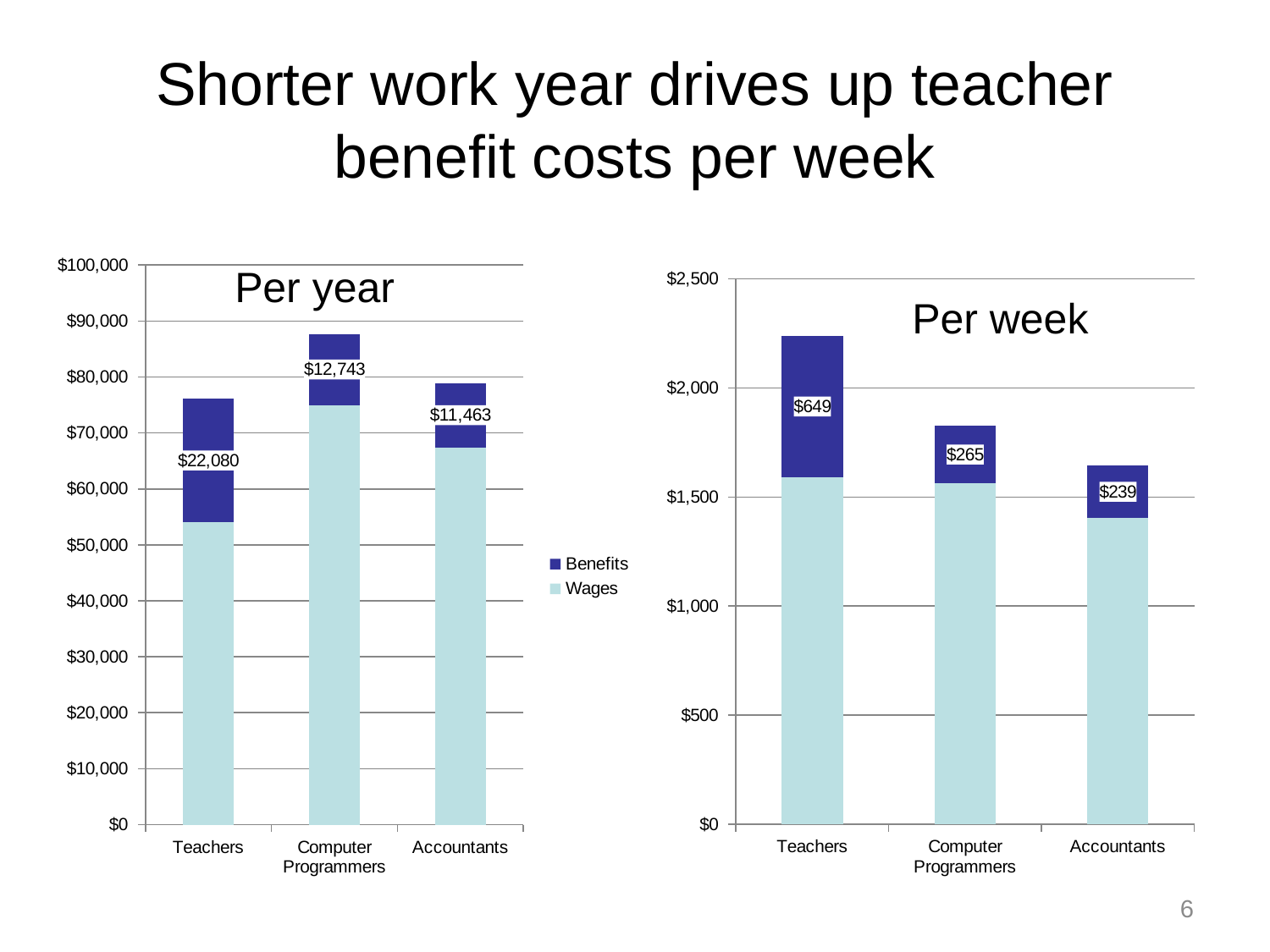
In the Per week chart, what is the difference between the Benefits values for Teachers and Computer Programmers? $384 In the Per year chart, which category has the lowest Benefits value? Accountants How many series does the legend list? 2 In the Per year chart, what is the Benefits value for Teachers? $22,080 In the Per year chart, is the Wages value for Computer Programmers greater or less than $70,000? greater In the Per year chart, what is the difference between the Benefits values for Teachers and Computer Programmers? $9,337 What kind of chart is the Per week chart? Stacked bar chart In the Per year chart, what is the Benefits value for Computer Programmers? $12,743 In the Per week chart, is the total bar height for Teachers greater or less than $2,000? greater In the Per week chart, is the Benefits value for Computer Programmers larger or smaller than that for Accountants? larger In the Per week chart, what is the Benefits value for Accountants? $239 In the Per week chart, which category has the highest Benefits value? Teachers